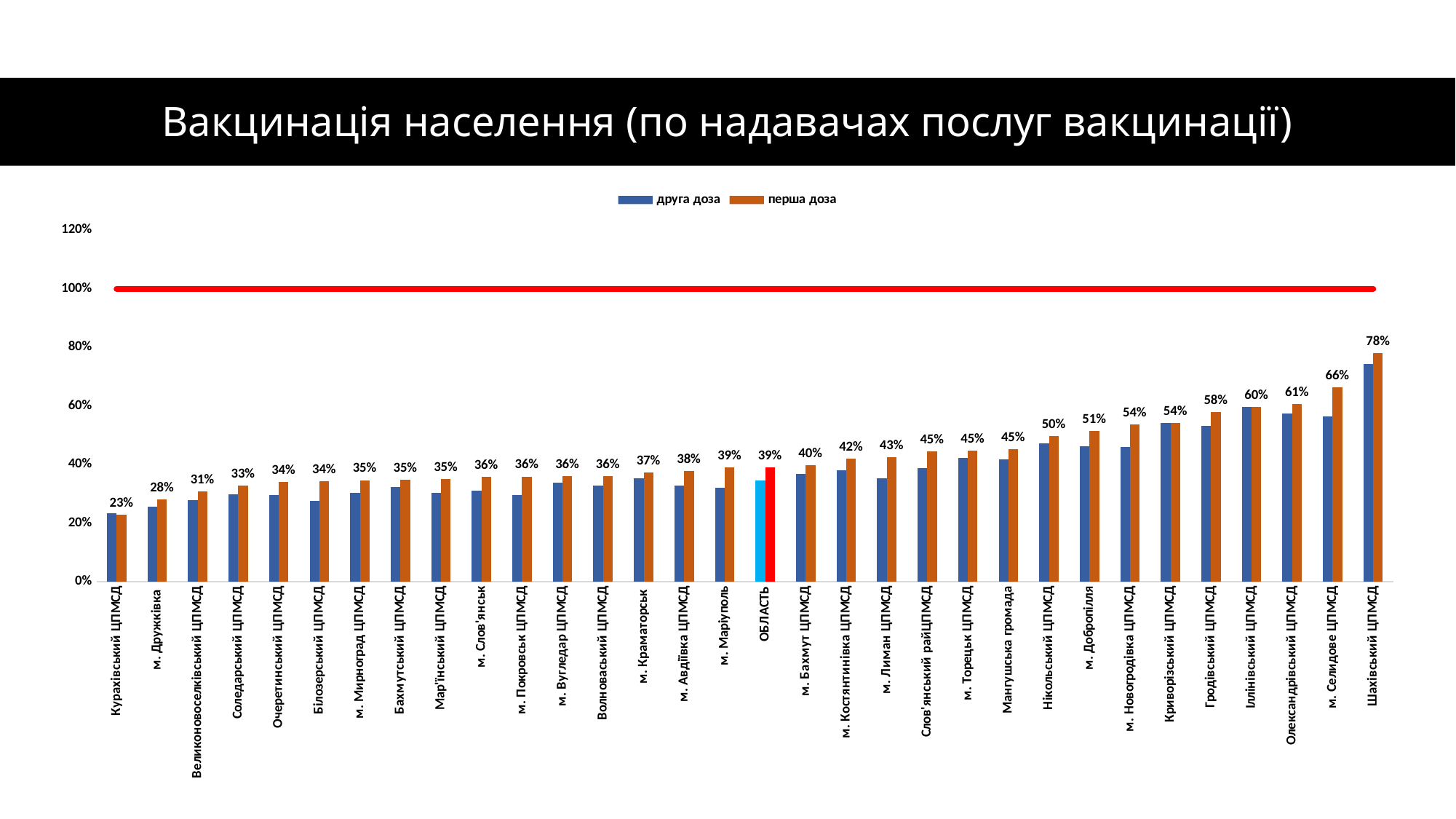
Which category has the highest 'перша доза' value? Шахівський ЦПМСД What is the 'перша доза' value for ОБЛАСТЬ? 39% Do the 'перша доза' values rise or fall from left to right along the x axis? rise Which category has the lowest 'перша доза' value? Курахівський ЦПМСД How many series does the legend list? 2 What is the 'перша доза' value for Шахівський ЦПМСД? 78% What type of chart is shown on the slide? bar chart Which has a higher 'перша доза' value, м. Добропілля or м. Дружківка? м. Добропілля Is the 'друга доза' value for Шахівський ЦПМСД greater or less than 60%? greater What is the difference between the 'перша доза' values for Шахівський ЦПМСД and Курахівський ЦПМСД? 55% What is the 'перша доза' value for м. Селидове ЦПМСД? 66% How many categories are shown on the x axis? 32